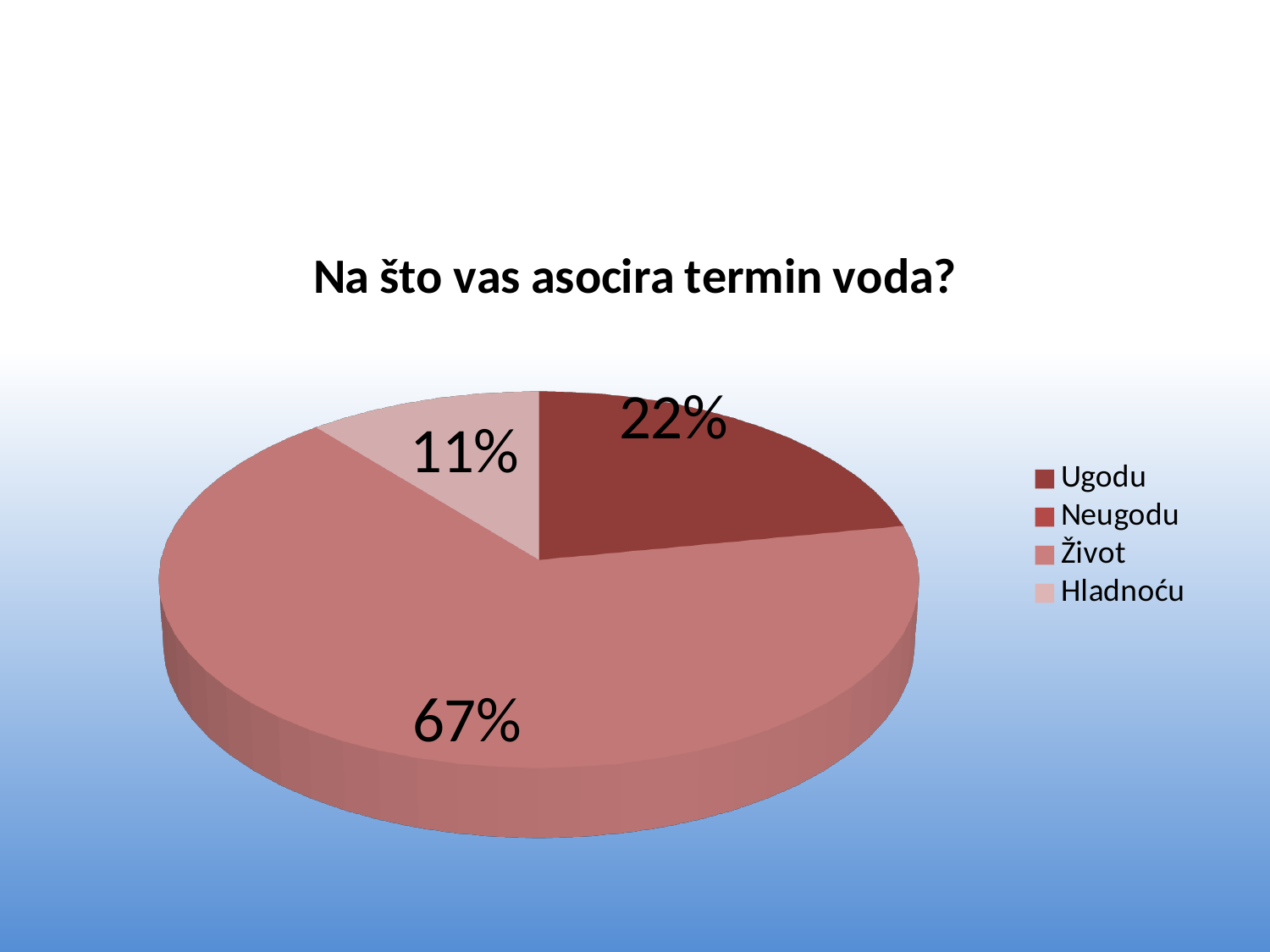
What percentage of the pie is labelled for Život? 67% How many entries does the legend list? 4 Which category has the largest slice of the pie? Život What percentage of the pie is labelled for Hladnoću? 11% What percentage of the pie is labelled for Ugodu? 22% What is the title of the chart? Na što vas asocira termin voda? What kind of chart is shown on the slide? pie chart Which legend entry is shown in the darkest red colour? Ugodu What share of the pie does the Život slice represent? 67% What is the difference in percentage points between the Ugodu slice and the Hladnoću slice? 11 What is the difference in percentage points between the Život slice and the Ugodu slice? 45 Which slice is larger, Ugodu or Hladnoću? Ugodu